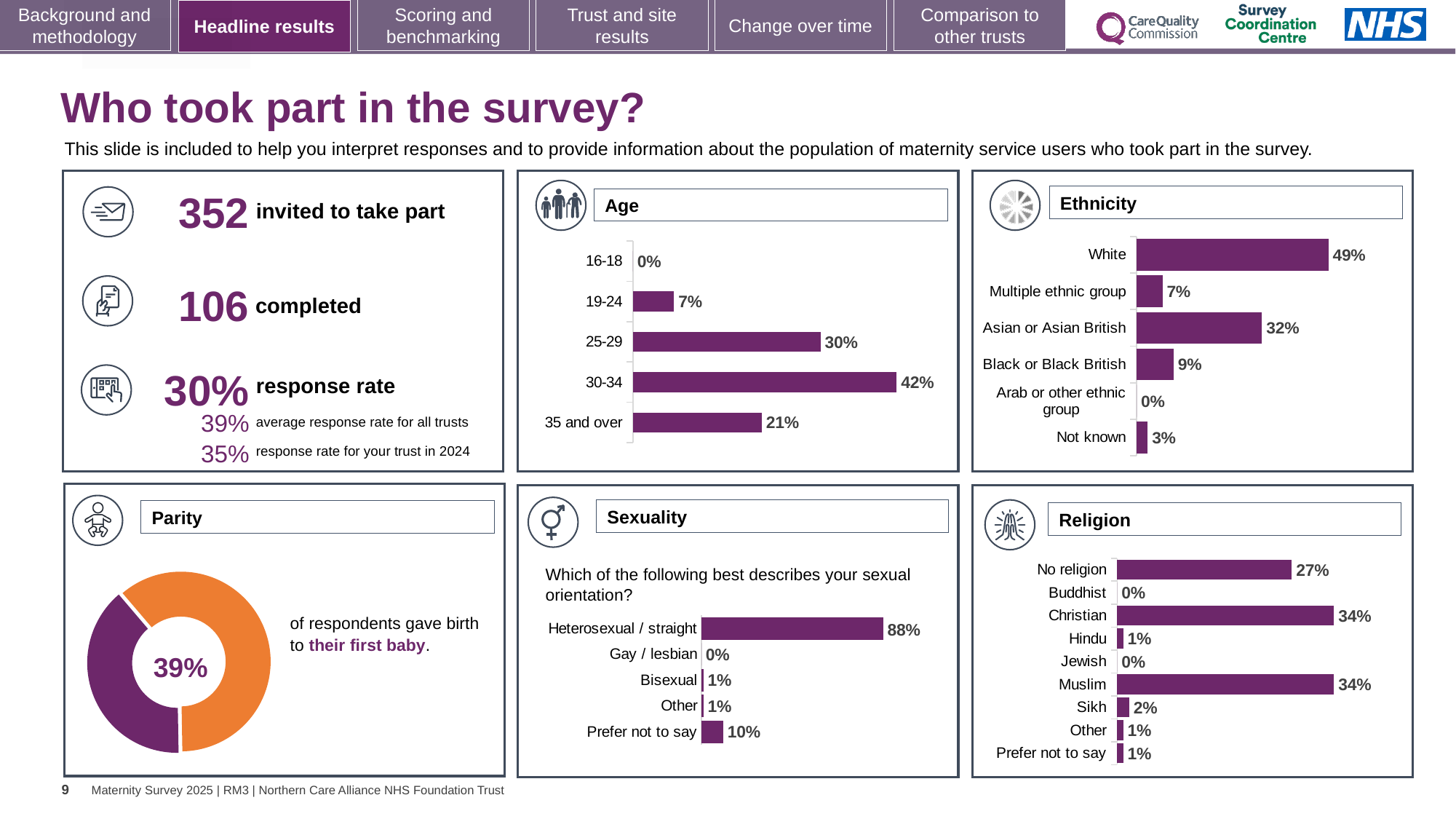
In the Religion chart, how many religion categories are shown? 9 What kind of chart is the Parity chart? Doughnut chart In the Age chart, which age group has the highest percentage? 30-34 In the Ethnicity chart, which is larger: Black or Black British or Multiple ethnic group? Black or Black British In the Sexuality chart, what percentage of respondents answered Heterosexual / straight? 88% In the Age chart, how many age categories are shown? 5 In the Age chart, what percentage of respondents were aged 30-34? 42% In the Parity chart, what percentage of respondents gave birth to their first baby? 39% In the Religion chart, what percentage of respondents were Muslim? 34% In the Sexuality chart, what percentage of respondents answered Prefer not to say? 10% In the Ethnicity chart, what is the difference between the percentages for White and Asian or Asian British? 17% In the Ethnicity chart, what percentage of respondents were White? 49%